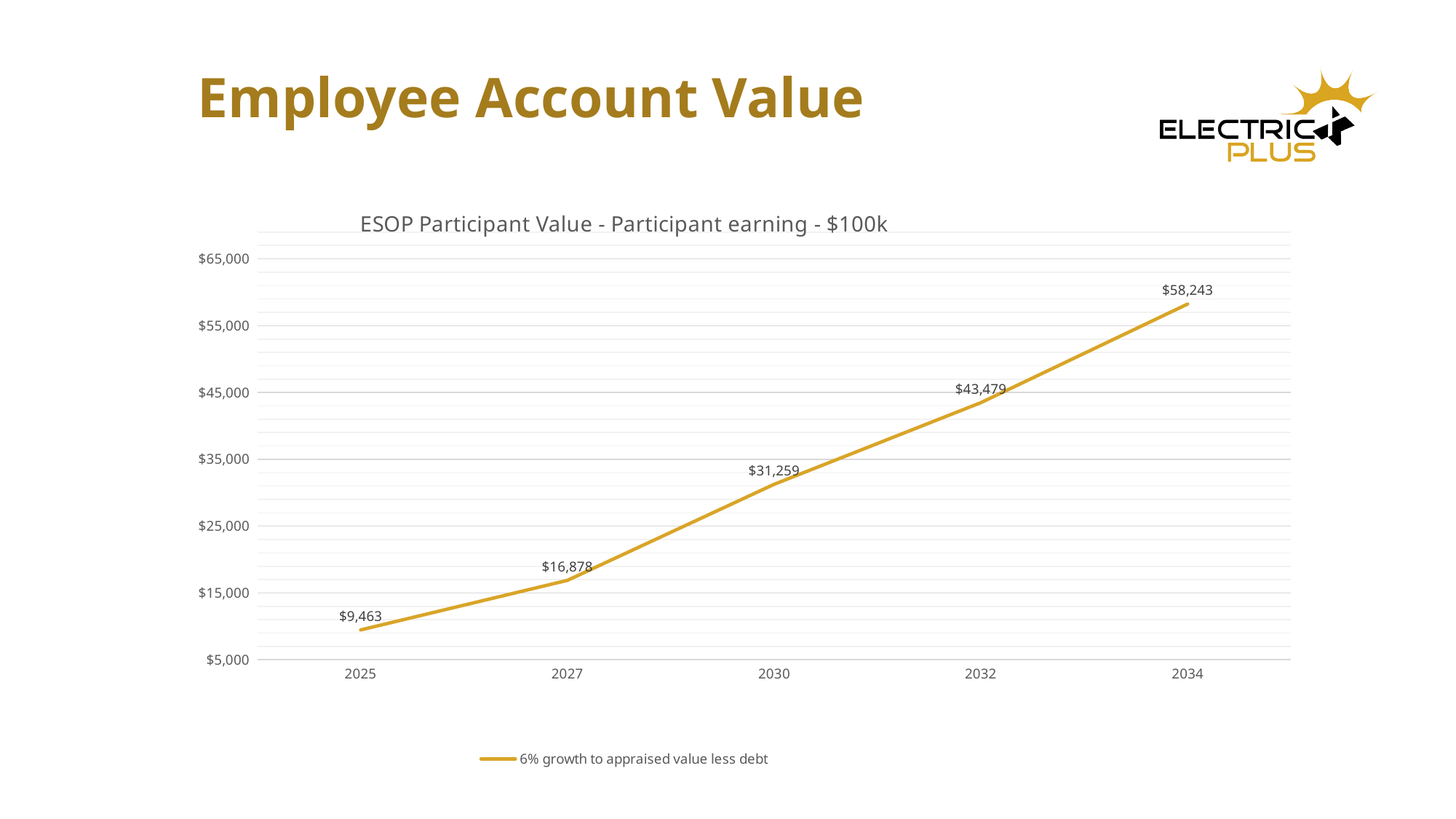
Which is larger, the value for 2030 or the value for 2027? 2030 How many years are plotted on the chart? 5 What is the value for 2025? $9,463 What is the difference between the values for 2027 and 2025? $7,415 What kind of chart is shown? line chart Which year has the highest value? 2034 What is the value for 2030? $31,259 Is the value for 2032 greater or less than $45,000? less Which year has the lowest value? 2025 Do the values rise or fall from 2025 to 2034? rise What is the value for 2034? $58,243 What is the difference between the values for 2034 and 2032? $14,764